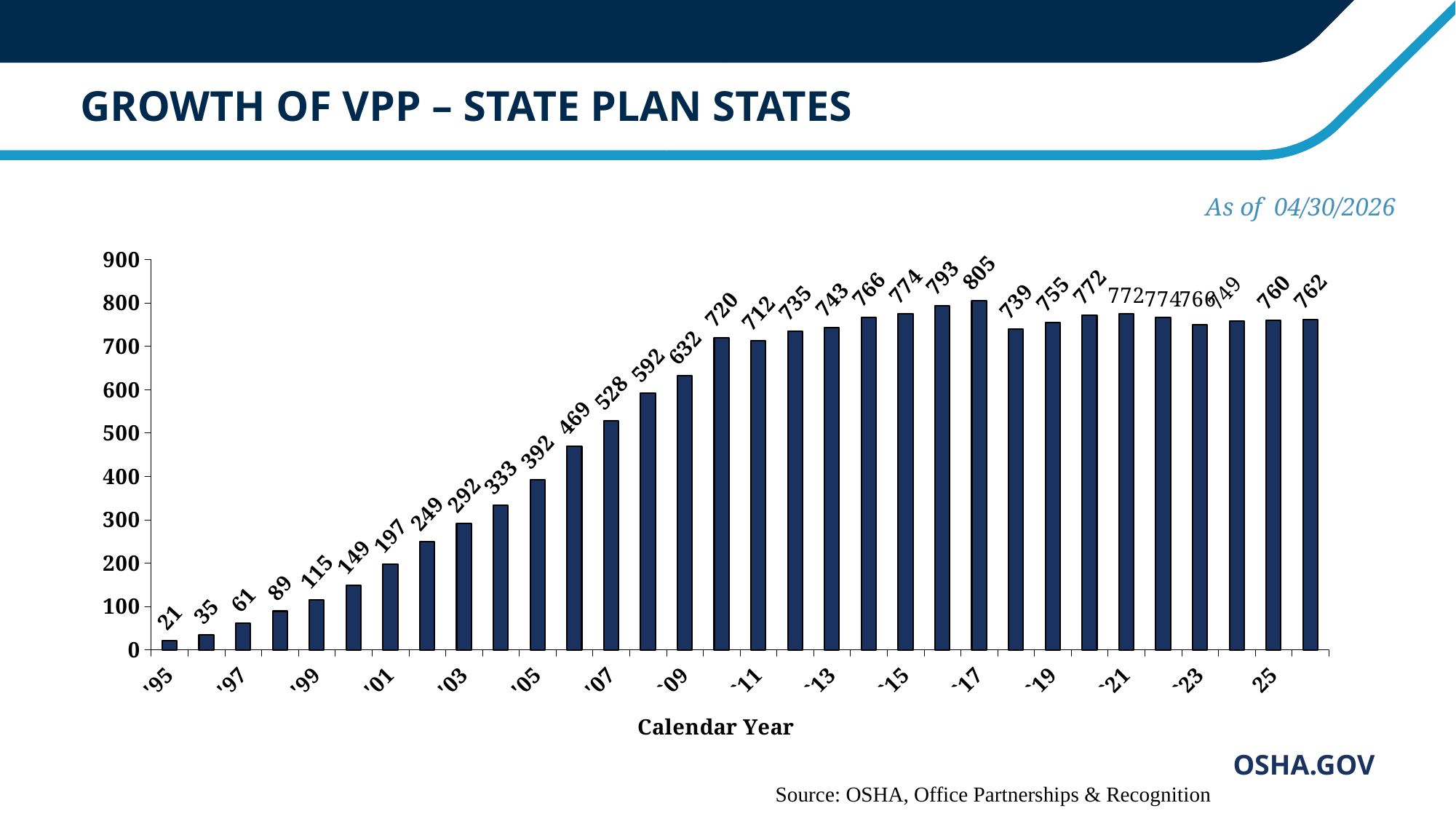
Which is larger, the value for '11 or the value for '13? '13 What is the x-axis title of the chart? Calendar Year Which year has the lowest value? '95 What is the value for '17? 805 Do the values generally rise or fall from '95 to '17? rise What is the value for '05? 392 What type of chart is shown on the slide? bar chart What is the value for '09? 632 Which year has the highest value? '17 What is the difference between the values for '17 and '19? 50 What is the value for '95? 21 Is the value for '07 greater or less than 500? greater